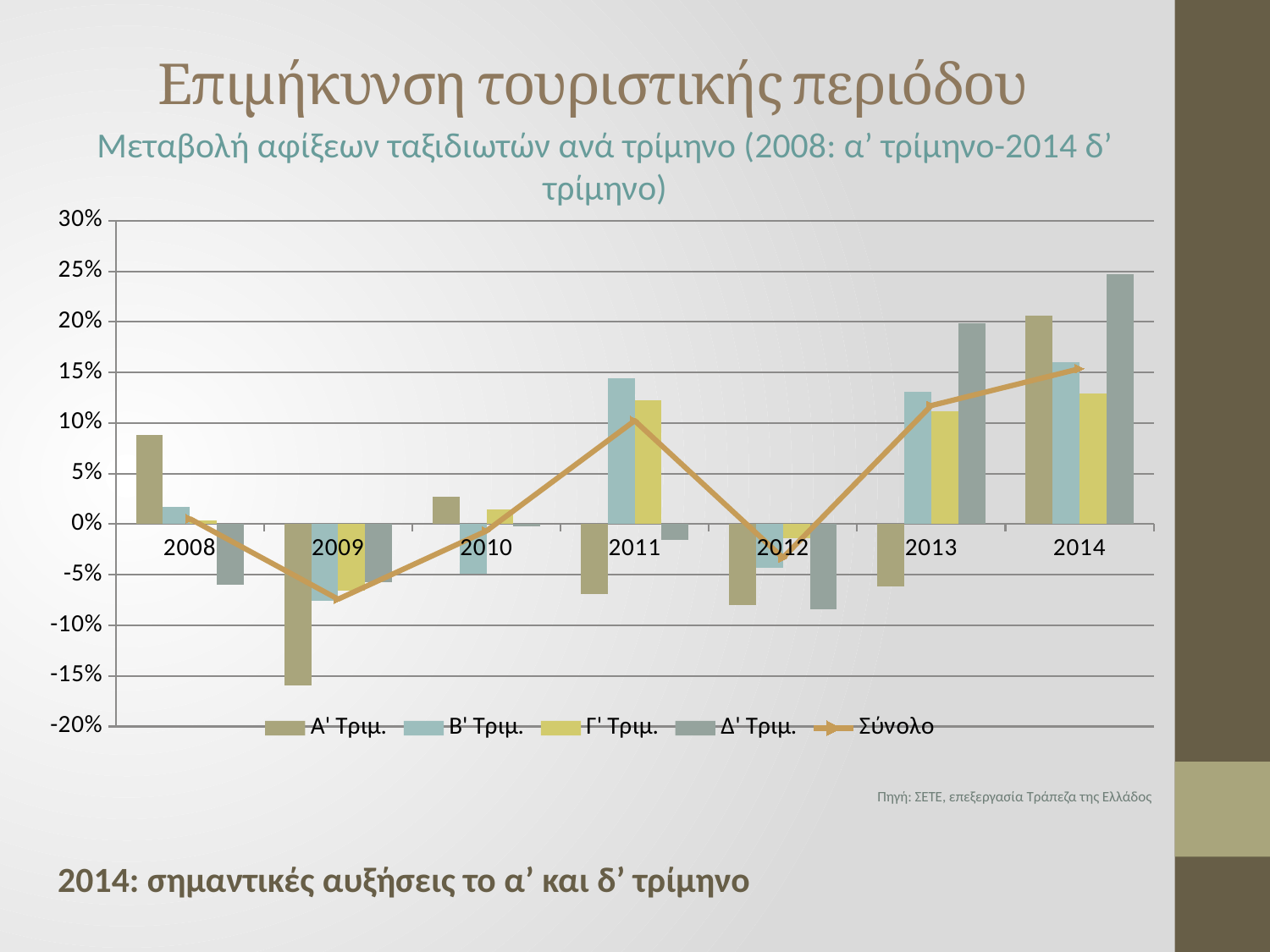
How many years are shown on the x axis of the chart? 7 In which year is the Δ' Τριμ. bar the highest? 2014 Is the value for Α' Τριμ. in 2009 greater or less than -15%? less Is the value for Δ' Τριμ. in 2014 greater or less than 20%? greater How many series does the chart legend list? 5 Which series in the legend is drawn as a line rather than bars? Σύνολο In 2011, which is larger: Β' Τριμ. or Γ' Τριμ.? Β' Τριμ. In 2013, which is larger: Α' Τριμ. or Δ' Τριμ.? Δ' Τριμ. Does the Σύνολο line rise or fall from 2012 to 2014? rises What kind of chart is shown on the slide? bar chart with a line Is the Σύνολο value for 2011 greater or less than 5%? greater In which year is the Α' Τριμ. bar the lowest? 2009